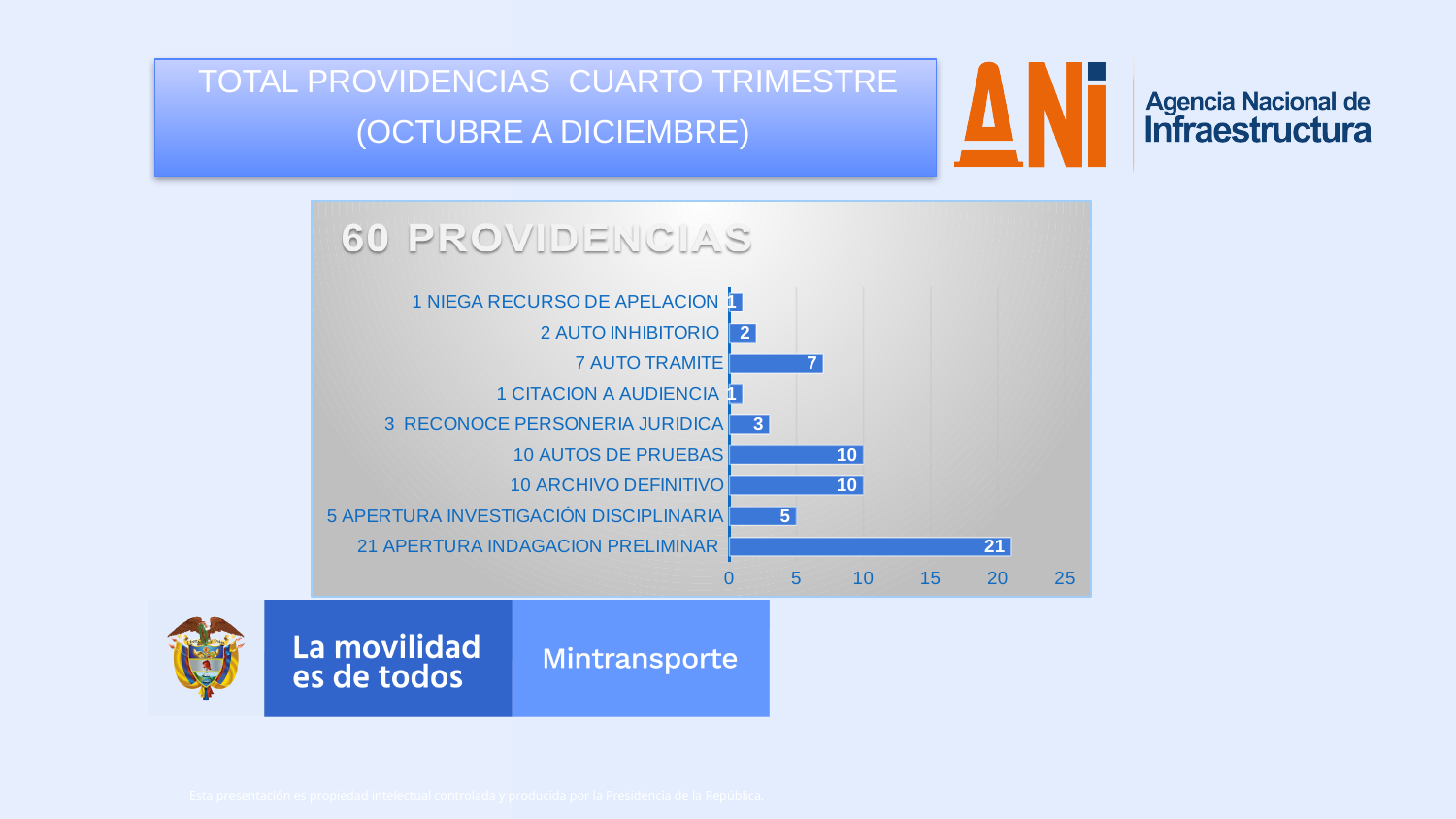
What is the value for APERTURA INDAGACION PRELIMINAR? 21 What is the difference between APERTURA INDAGACION PRELIMINAR and AUTOS DE PRUEBAS? 11 What kind of chart is shown? bar chart Is the value for APERTURA INDAGACION PRELIMINAR greater or less than 20? greater Which category has the highest value? APERTURA INDAGACION PRELIMINAR What is the difference between ARCHIVO DEFINITIVO and APERTURA INVESTIGACIÓN DISCIPLINARIA? 5 How many categories are shown in the chart? 9 What is the value for AUTO TRAMITE? 7 What is the value for APERTURA INVESTIGACIÓN DISCIPLINARIA? 5 Which is larger, AUTO TRAMITE or RECONOCE PERSONERIA JURIDICA? AUTO TRAMITE What is the title of the chart? 60 PROVIDENCIAS What is the value for AUTO INHIBITORIO? 2